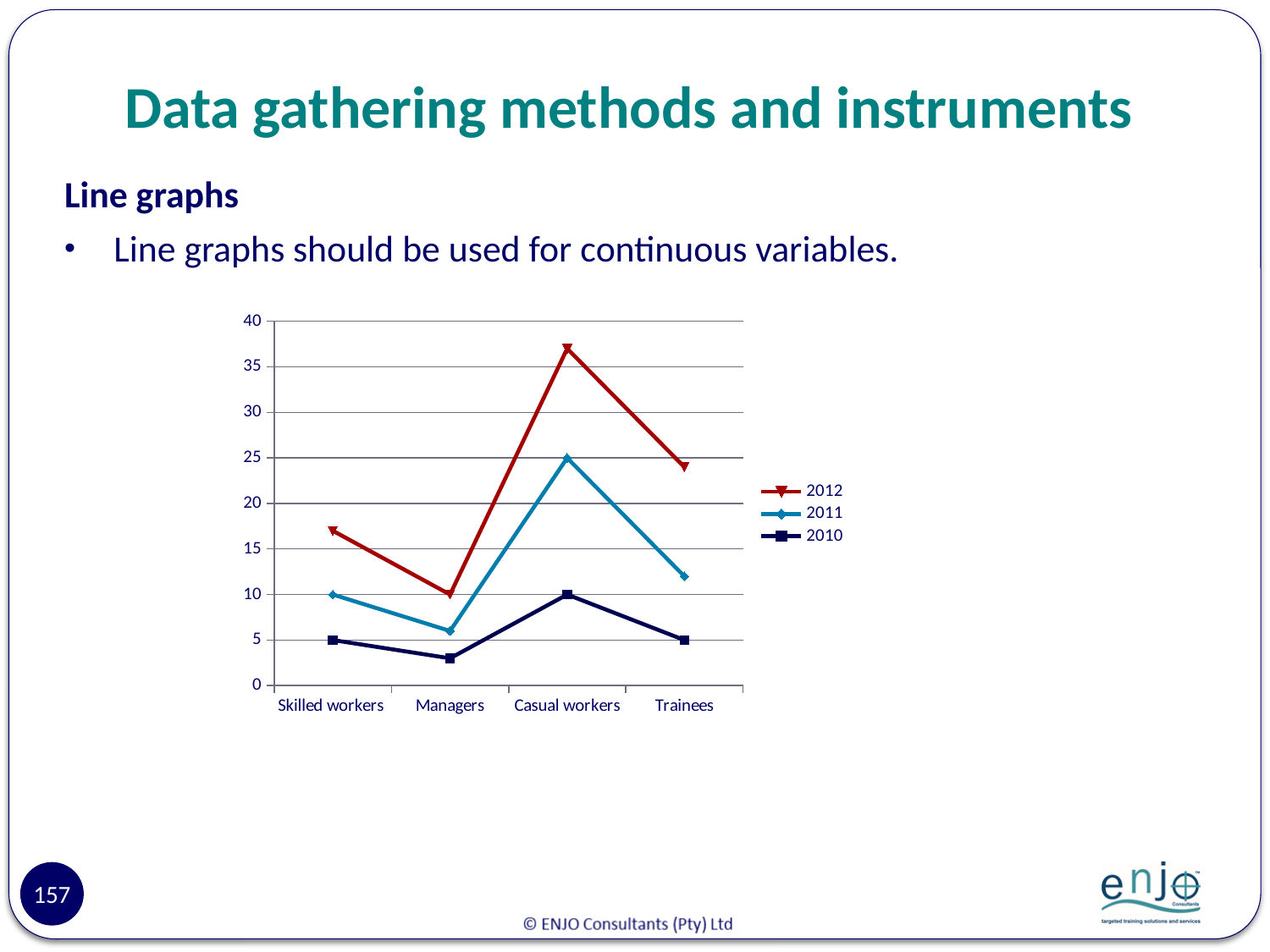
Which category has the lowest value in the 2010 series? Managers Is the value for Managers in the 2010 series greater or less than 5? less What kind of chart is shown on the slide? line chart What is the value for Casual workers in the 2010 series? 10 How many series does the legend list? 3 How many categories are shown on the x axis? 4